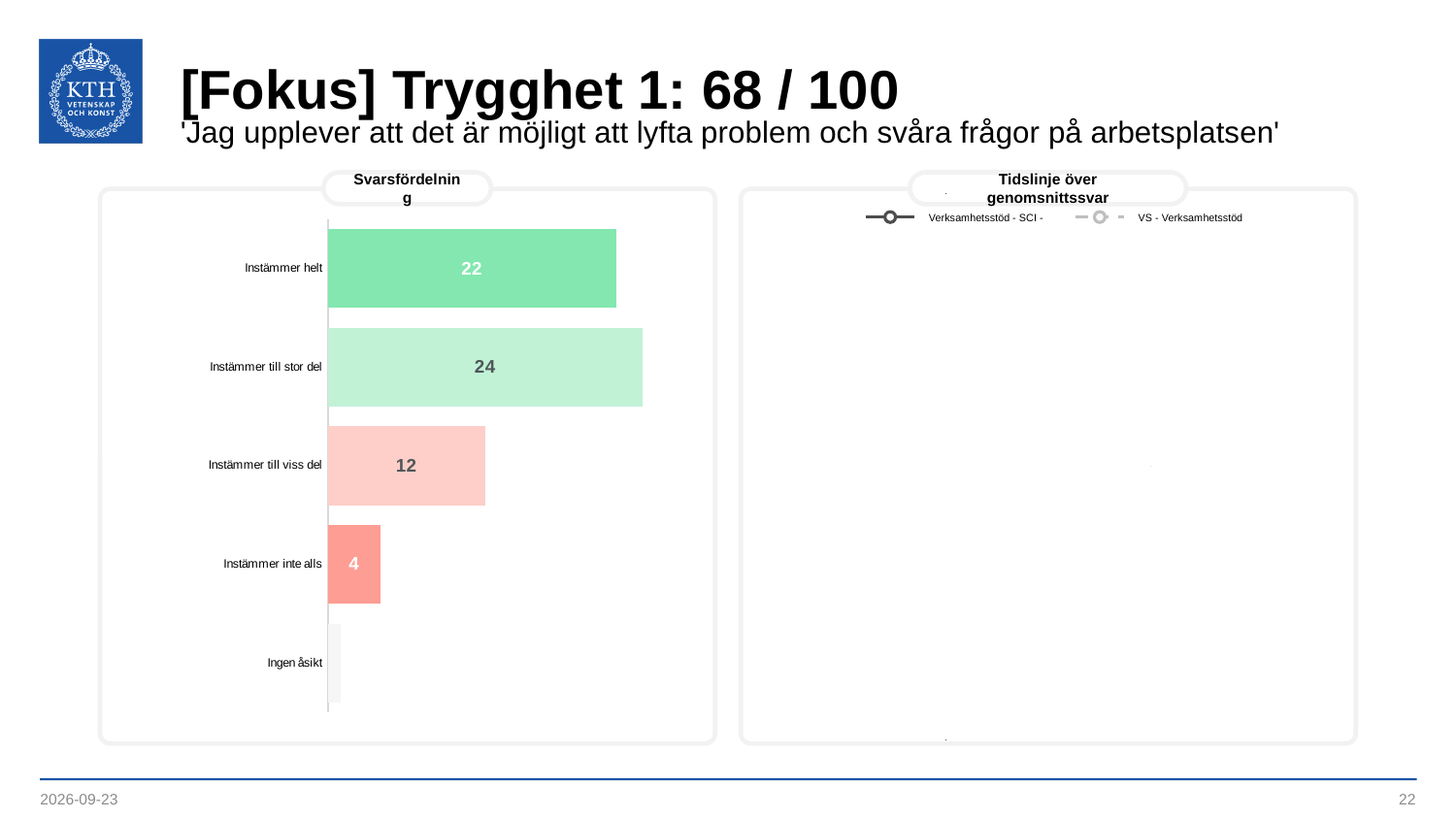
In the 'Svarsfördelning' chart, what is the difference between 'Instämmer till viss del' and 'Instämmer inte alls'? 8 In the 'Svarsfördelning' chart, what is the value for 'Instämmer inte alls'? 4 In the 'Svarsfördelning' chart, what is the value for 'Instämmer till stor del'? 24 How many categories are shown in the 'Svarsfördelning' chart? 5 How many series does the legend of the 'Tidslinje över genomsnittssvar' chart list? 2 In the 'Svarsfördelning' chart, which category has the highest value? Instämmer till stor del In the 'Svarsfördelning' chart, which category has the lowest value? Ingen åsikt In the 'Svarsfördelning' chart, what is the value for 'Instämmer helt'? 22 What kind of chart is the 'Svarsfördelning' chart? Bar chart In the 'Svarsfördelning' chart, what is the value for 'Instämmer till viss del'? 12 In the 'Svarsfördelning' chart, what is the difference between 'Instämmer till stor del' and 'Instämmer helt'? 2 In the 'Svarsfördelning' chart, which is larger: 'Instämmer helt' or 'Instämmer till viss del'? Instämmer helt